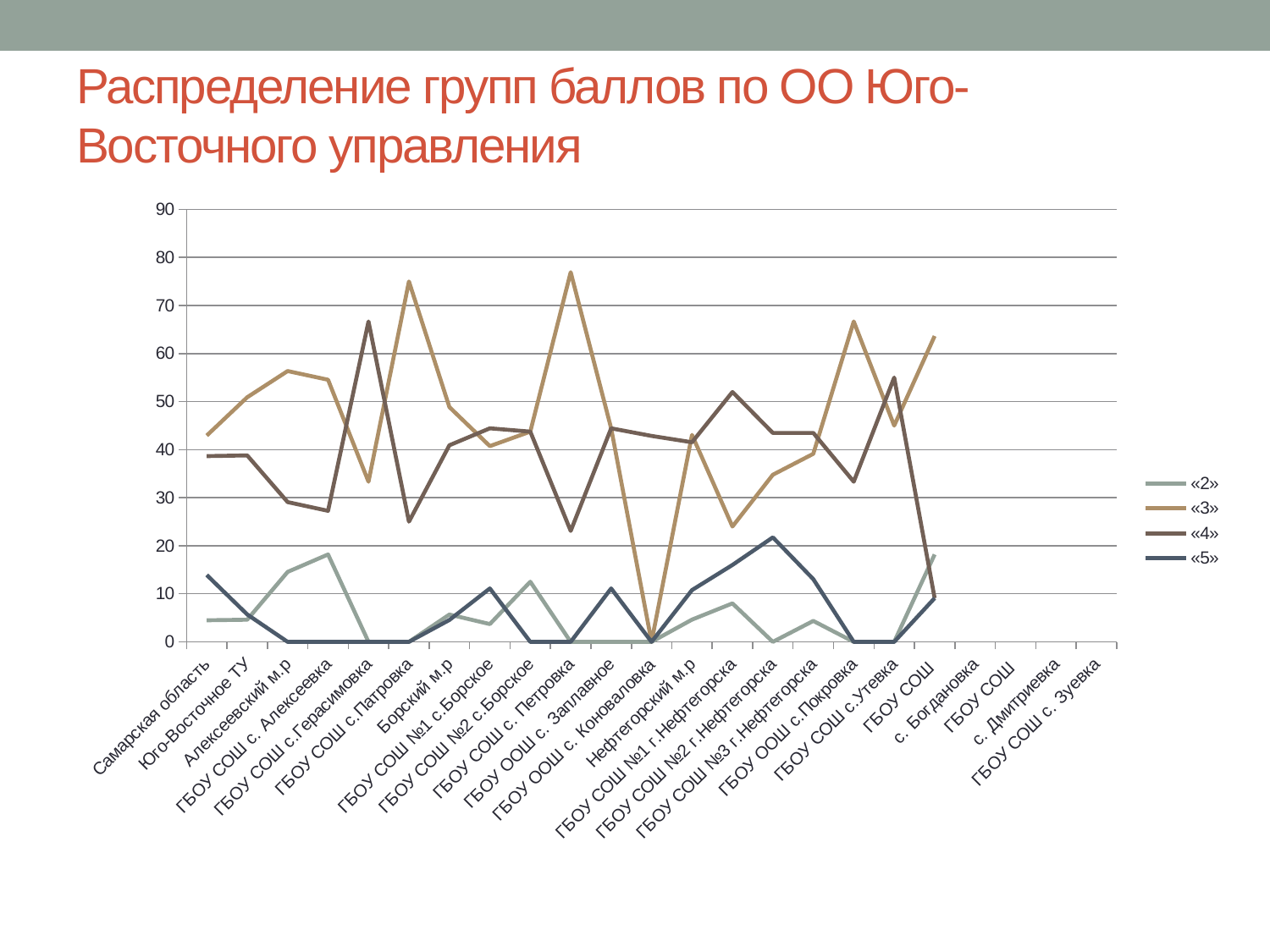
Is the value of series «3» for ГБОУ СОШ с.Патровка greater or less than 70? greater Is the value of series «4» for ГБОУ СОШ с.Герасимовка greater or less than 60? greater Is the value of series «4» for ГБОУ СОШ с.Патровка greater or less than 30? less Which category has the highest value for series «4»? ГБОУ СОШ с.Герасимовка What is the value of series «5» for ГБОУ СОШ с. Алексеевка? 0 Which category has the highest value for series «5»? ГБОУ СОШ №2 г.Нефтегорска Which series are listed in the legend? «2», «3», «4», «5» How many series does the legend list? 4 How many categories are labelled along the x axis? 23 What kind of chart is shown on the slide? line chart